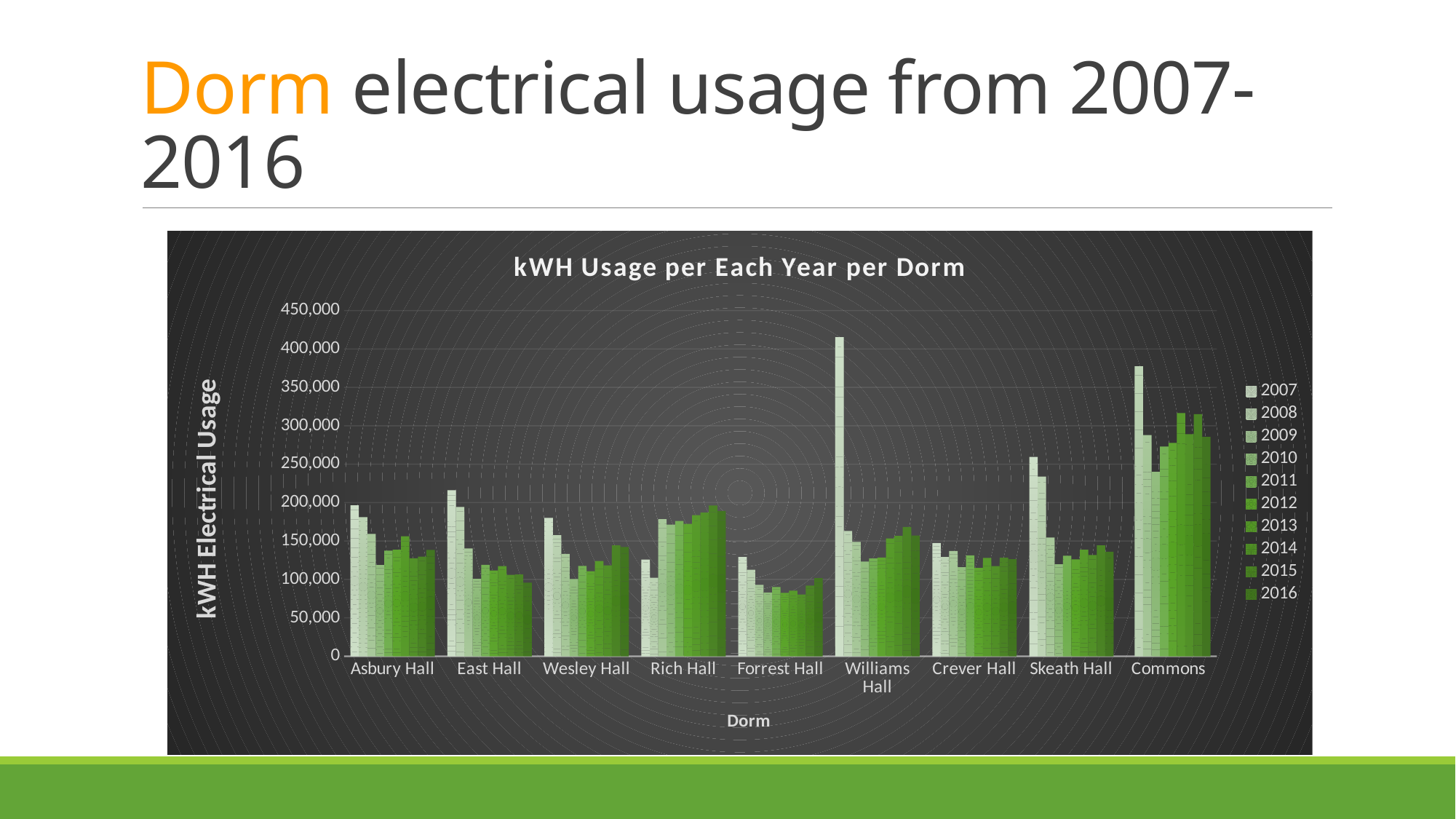
Which dorm has the single tallest bar in the chart? Williams Hall Is the 2007 value for Williams Hall greater or less than 350,000? greater What is the label on the vertical axis of the chart? kWH Electrical Usage What kind of chart is shown on the slide? Bar chart How many series (years) does the chart legend list? 10 What is the title of the chart? kWH Usage per Each Year per Dorm How many dorms are shown along the x axis of the chart? 9 Is the 2007 value for Forrest Hall greater or less than 150,000? less Is the 2007 value for Asbury Hall greater or less than 150,000? greater